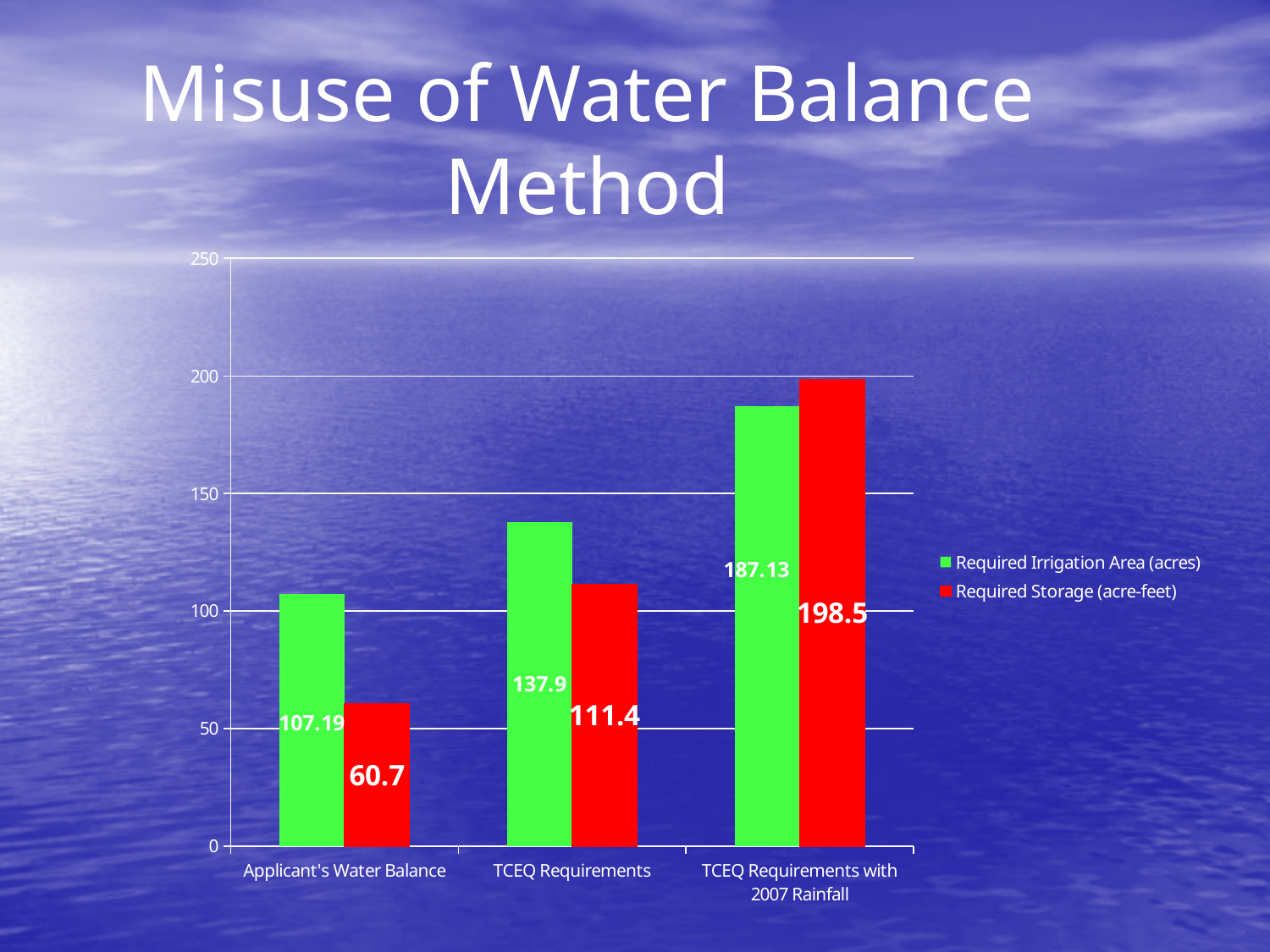
Which category has the highest Required Irrigation Area (acres)? TCEQ Requirements with 2007 Rainfall What is the difference between Required Storage (acre-feet) for TCEQ Requirements with 2007 Rainfall and for Applicant's Water Balance? 137.8 How many series does the legend list? 2 Is the Required Irrigation Area (acres) for TCEQ Requirements with 2007 Rainfall greater or less than 150? greater What kind of chart is shown on the slide? bar chart Which is larger for TCEQ Requirements: Required Irrigation Area (acres) or Required Storage (acre-feet)? Required Irrigation Area (acres) How many categories are shown on the x axis? 3 Which category has the lowest Required Storage (acre-feet)? Applicant's Water Balance What is the Required Storage (acre-feet) for TCEQ Requirements? 111.4 What is the Required Irrigation Area (acres) for Applicant's Water Balance? 107.19 What colour represents Required Storage (acre-feet) in the chart? red What is the Required Storage (acre-feet) for TCEQ Requirements with 2007 Rainfall? 198.5